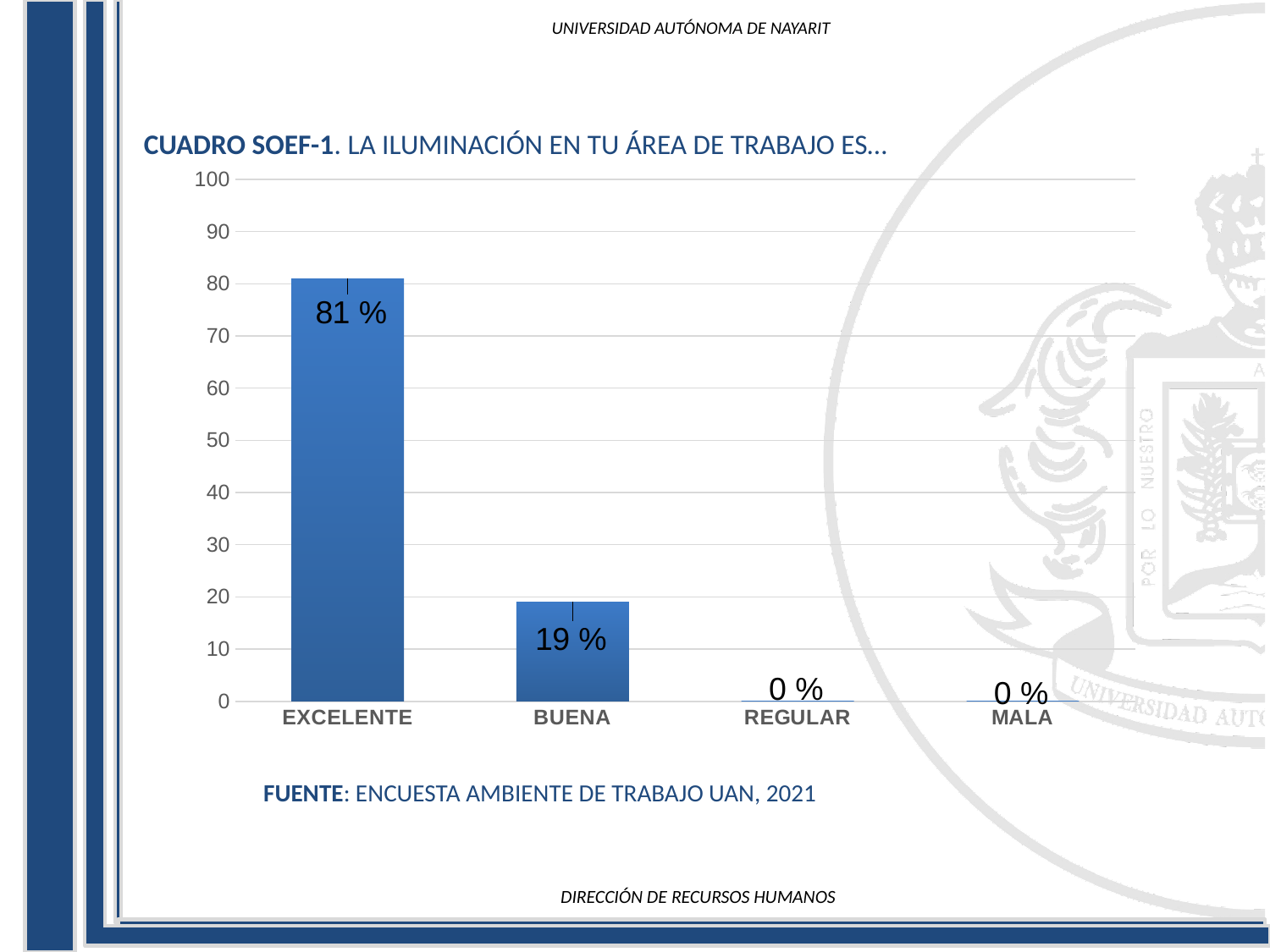
How many categories are shown on the x axis? 4 What is the value for EXCELENTE? 81 % Is the value for BUENA greater or less than 30? less Is the value for EXCELENTE greater or less than 50? greater What is the value for MALA? 0 % What kind of chart is shown on the slide? bar chart What is the source cited below the chart? ENCUESTA AMBIENTE DE TRABAJO UAN, 2021 What is the value for BUENA? 19 % What is the difference between the values for EXCELENTE and BUENA? 62 % Which is larger, the value for EXCELENTE or the value for BUENA? EXCELENTE What is the value for REGULAR? 0 % Which category has the highest value? EXCELENTE